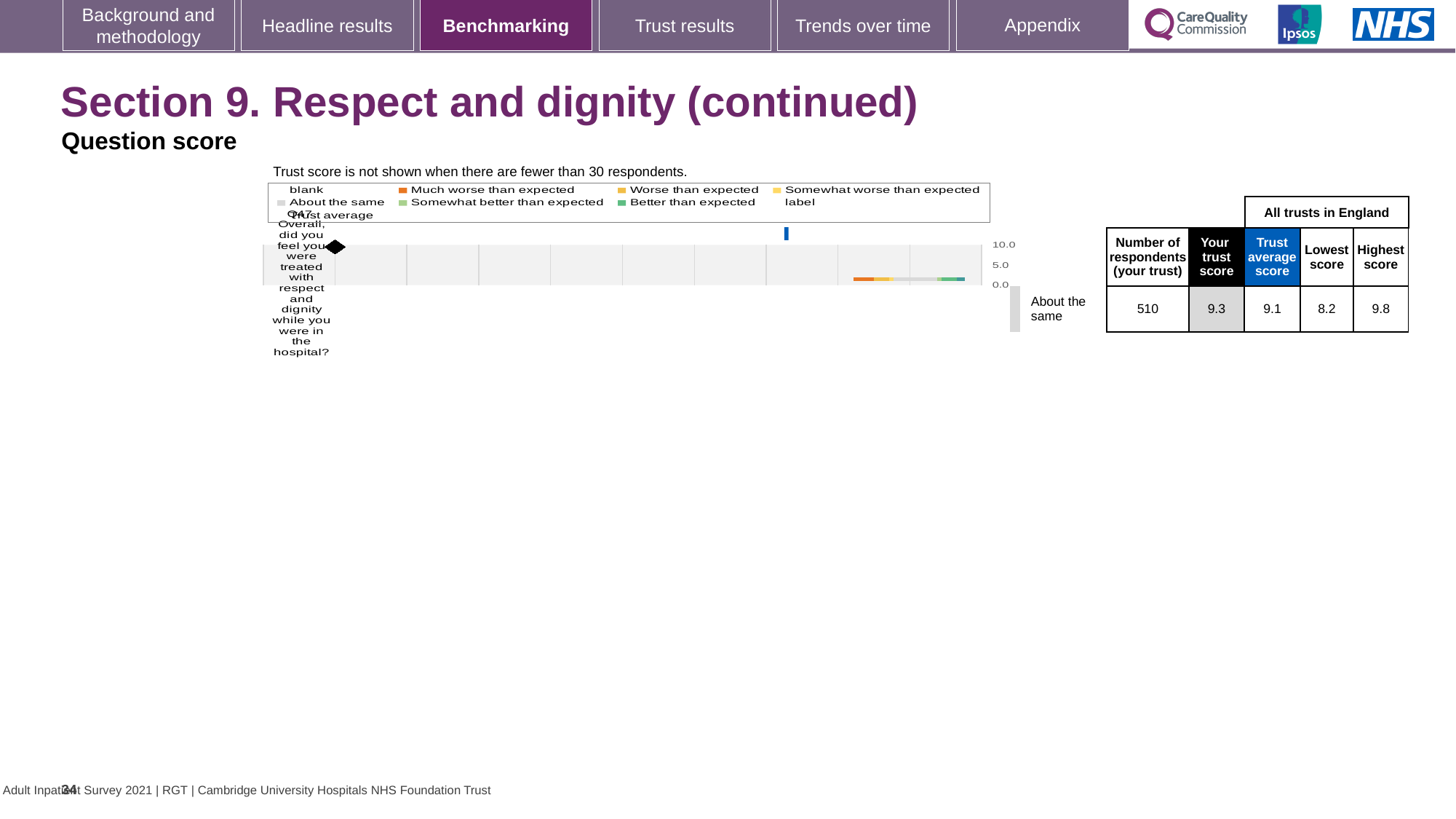
What is the highest value shown on the chart's score axis? 10.0 In the table beside the chart, what is the highest score among all trusts in England? 9.8 In the table beside the chart, what is the number of respondents for your trust? 510 What is the difference between the highest score and the lowest score among all trusts in England? 1.6 In the table beside the chart, what is the trust average score for all trusts in England? 9.1 Is your trust score for Q47 greater or less than 5.0? greater In the table beside the chart, what is the lowest score among all trusts in England? 8.2 In the table beside the chart, what is your trust score for Q47? 9.3 Which is larger, your trust score or the trust average score? Your trust score What is the question number shown on the chart's category label? Q47 What benchmark category is shown next to the chart for Q47? About the same What kind of chart is used to show the benchmarking result for Q47? bar chart